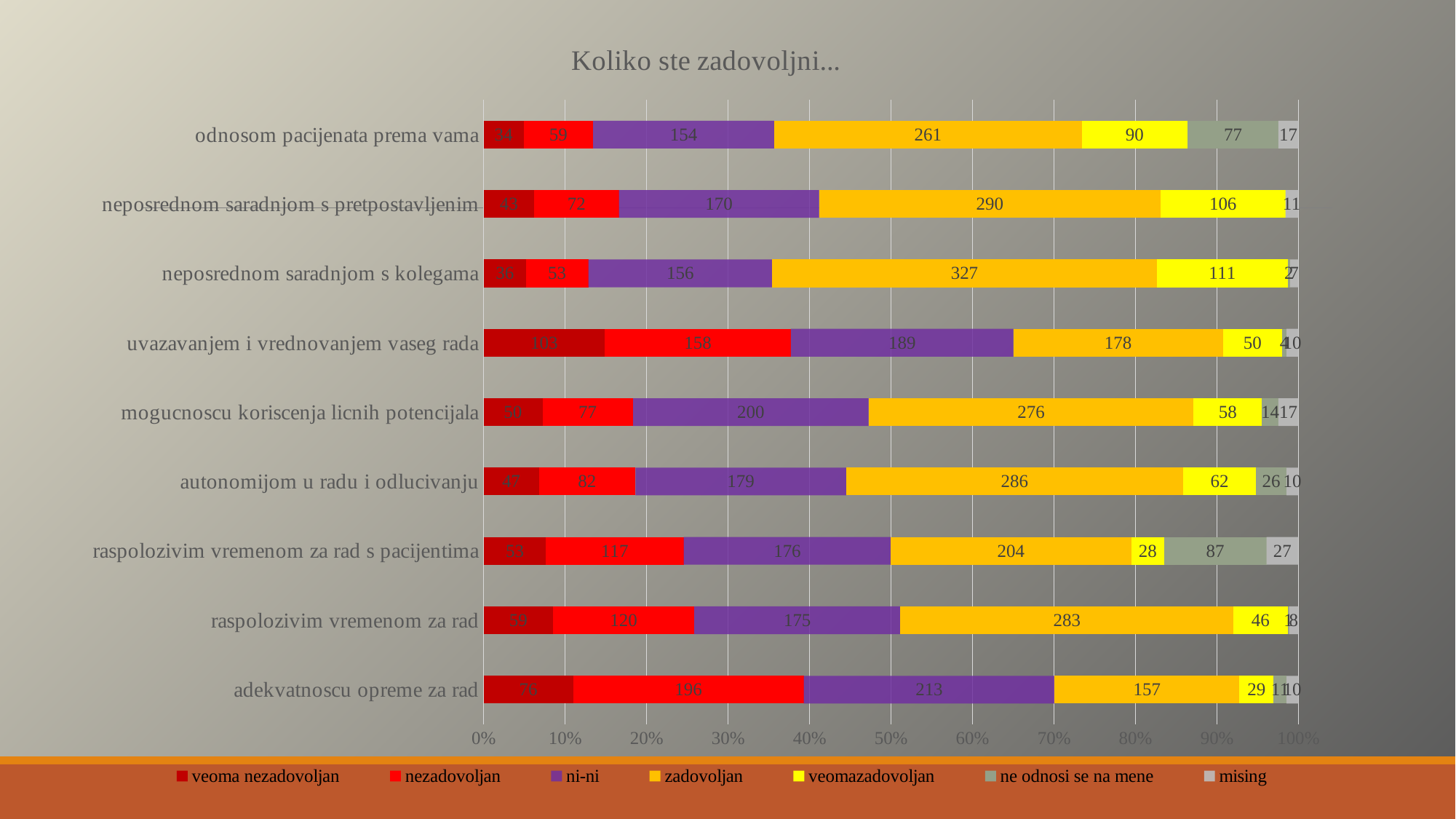
What is the 'ni-ni' value for 'mogucnoscu koriscenja licnih potencijala'? 200 What is the difference between the 'zadovoljan' values for 'neposrednom saradnjom s kolegama' and 'odnosom pacijenata prema vama'? 66 What kind of chart is shown on the slide? stacked bar chart What is the 'zadovoljan' value for 'neposrednom saradnjom s kolegama'? 327 What is the 'nezadovoljan' value for 'adekvatnoscu opreme za rad'? 196 Which category has the highest 'zadovoljan' value? neposrednom saradnjom s kolegama How many categories are plotted on the chart? 9 How many series does the legend list? 7 Which has the larger 'nezadovoljan' value: 'adekvatnoscu opreme za rad' or 'raspolozivim vremenom za rad'? adekvatnoscu opreme za rad Which category has the lowest 'veomazadovoljan' value? raspolozivim vremenom za rad s pacijentima What is the 'ne odnosi se na mene' value for 'raspolozivim vremenom za rad s pacijentima'? 87 What is the title of the chart? Koliko ste zadovoljni...